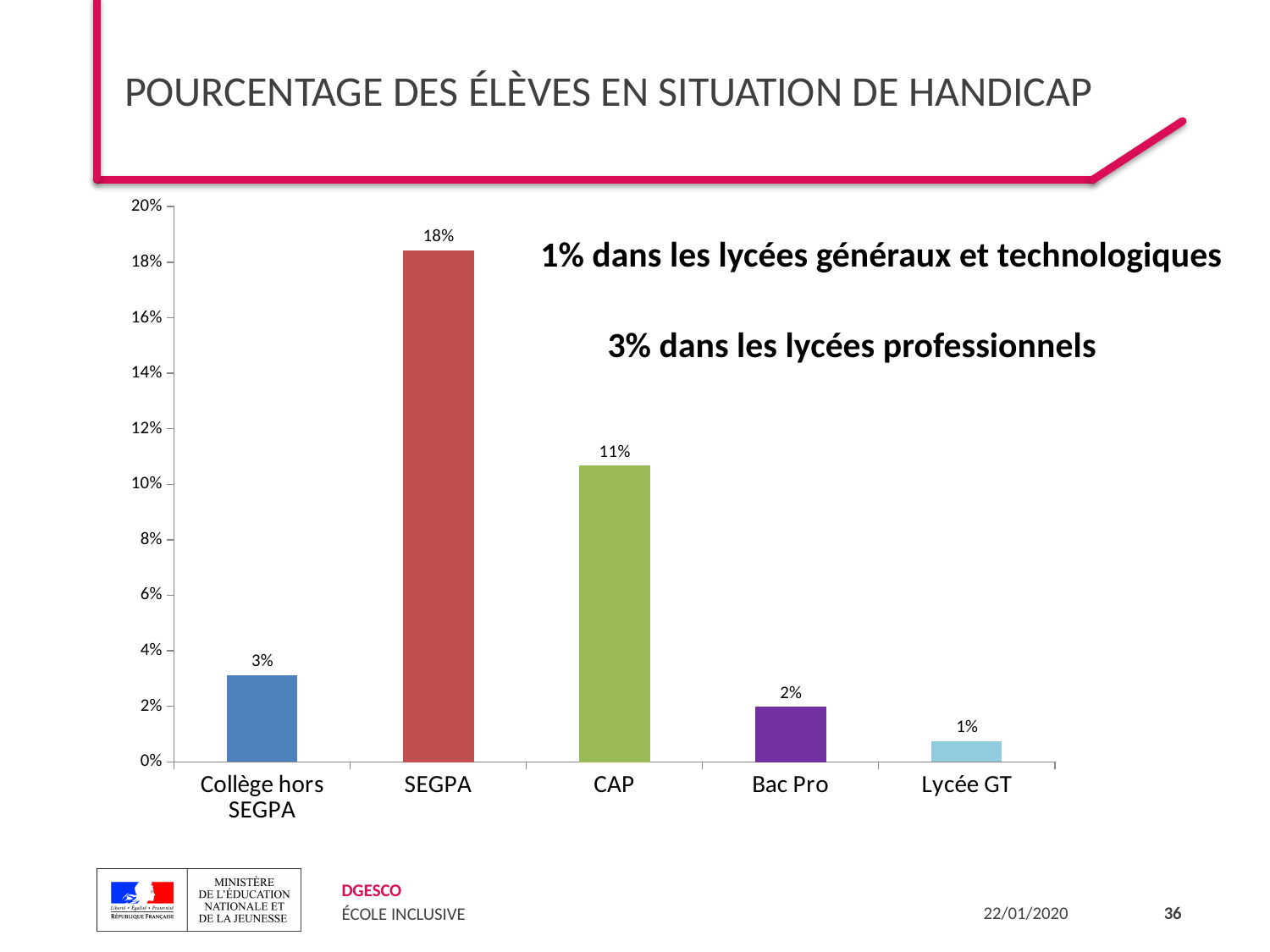
What is the difference between the values for SEGPA and CAP? 7% Which category has the lowest value? Lycée GT What is the value for Collège hors SEGPA? 3% Is the value for CAP greater or less than 10%? greater Which category has the highest value? SEGPA What kind of chart is shown on the slide? bar chart Which is larger, the value for Bac Pro or the value for Collège hors SEGPA? Collège hors SEGPA What is the value for Lycée GT? 1% What is the title of the slide? POURCENTAGE DES ÉLÈVES EN SITUATION DE HANDICAP What is the value for SEGPA? 18% How many categories are shown on the x axis? 5 What is the value for CAP? 11%